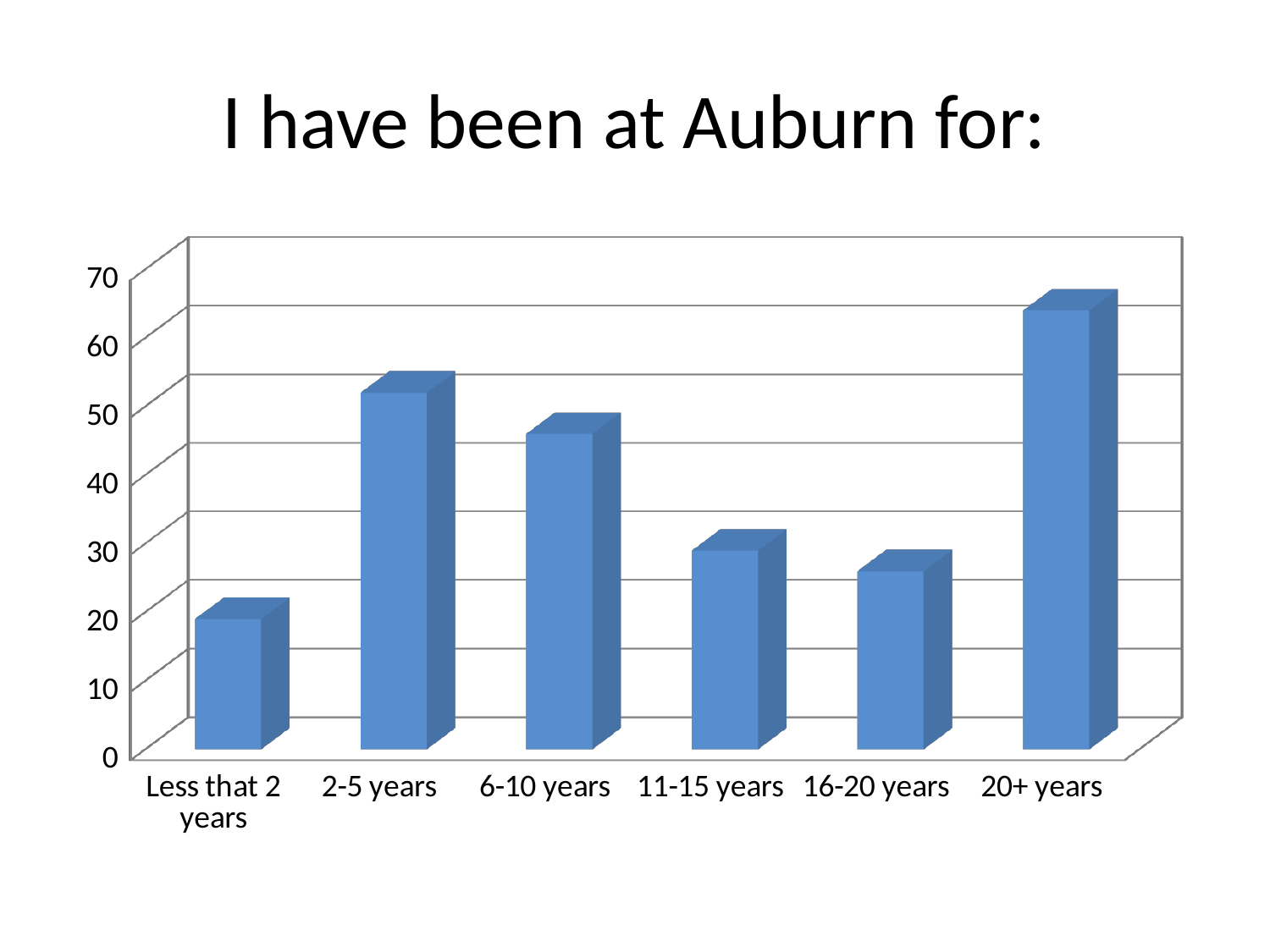
Is the value for 6-10 years greater or less than 50? less What is the title of the chart? I have been at Auburn for: How many categories are shown on the x axis? 6 Which category has the highest bar? 20+ years Is the value for 2-5 years greater or less than 40? greater Is the value for 20+ years greater or less than 60? greater Which category has the lowest bar? Less that 2 years Which is larger, the value for 2-5 years or the value for 6-10 years? 2-5 years What type of chart is shown on the slide? bar chart Which is larger, the value for 20+ years or the value for 2-5 years? 20+ years